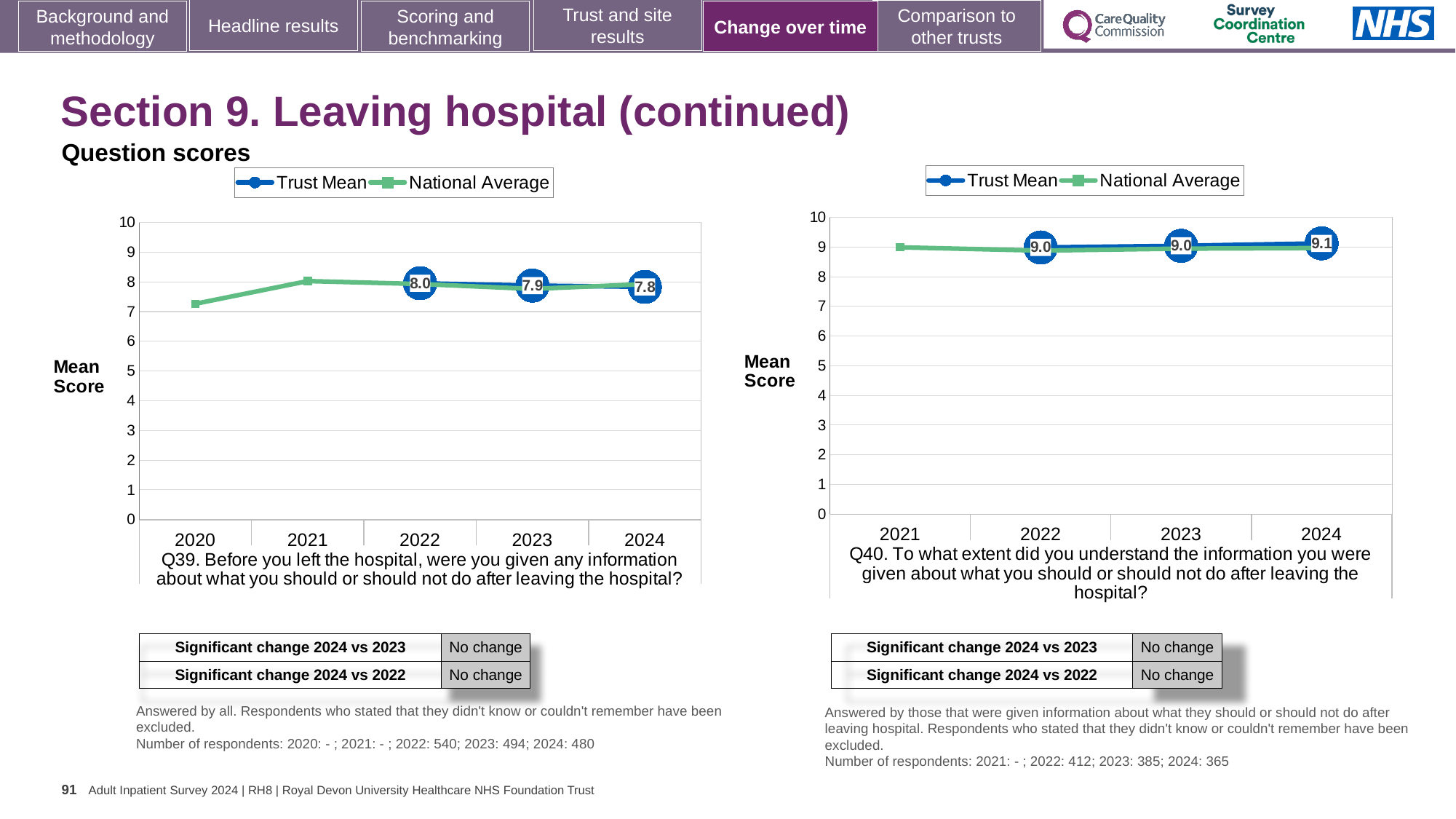
How many years are shown on the x axis of the Q40 chart on the right? 4 In the Q39 chart on the left, which year has the lowest labelled Trust Mean score? 2024 How many series does the legend of the Q39 chart on the left list? 2 In the Q40 chart on the right, what is the Trust Mean score for 2023? 9.0 In the Q39 chart on the left, which year has the highest labelled Trust Mean score? 2022 In the Q39 chart on the left, is the National Average for 2020 greater or less than 8? less In the Q39 chart on the left, what is the Trust Mean score for 2024? 7.8 What type of chart is the Q40 chart on the right? Line chart In the Q39 chart on the left, what is the Trust Mean score for 2022? 8.0 In the Q39 chart on the left, what is the difference between the Trust Mean scores for 2022 and 2024? 0.2 In the Q40 chart on the right, what is the Trust Mean score for 2024? 9.1 In the Q40 chart on the right, which year has the highest Trust Mean score? 2024